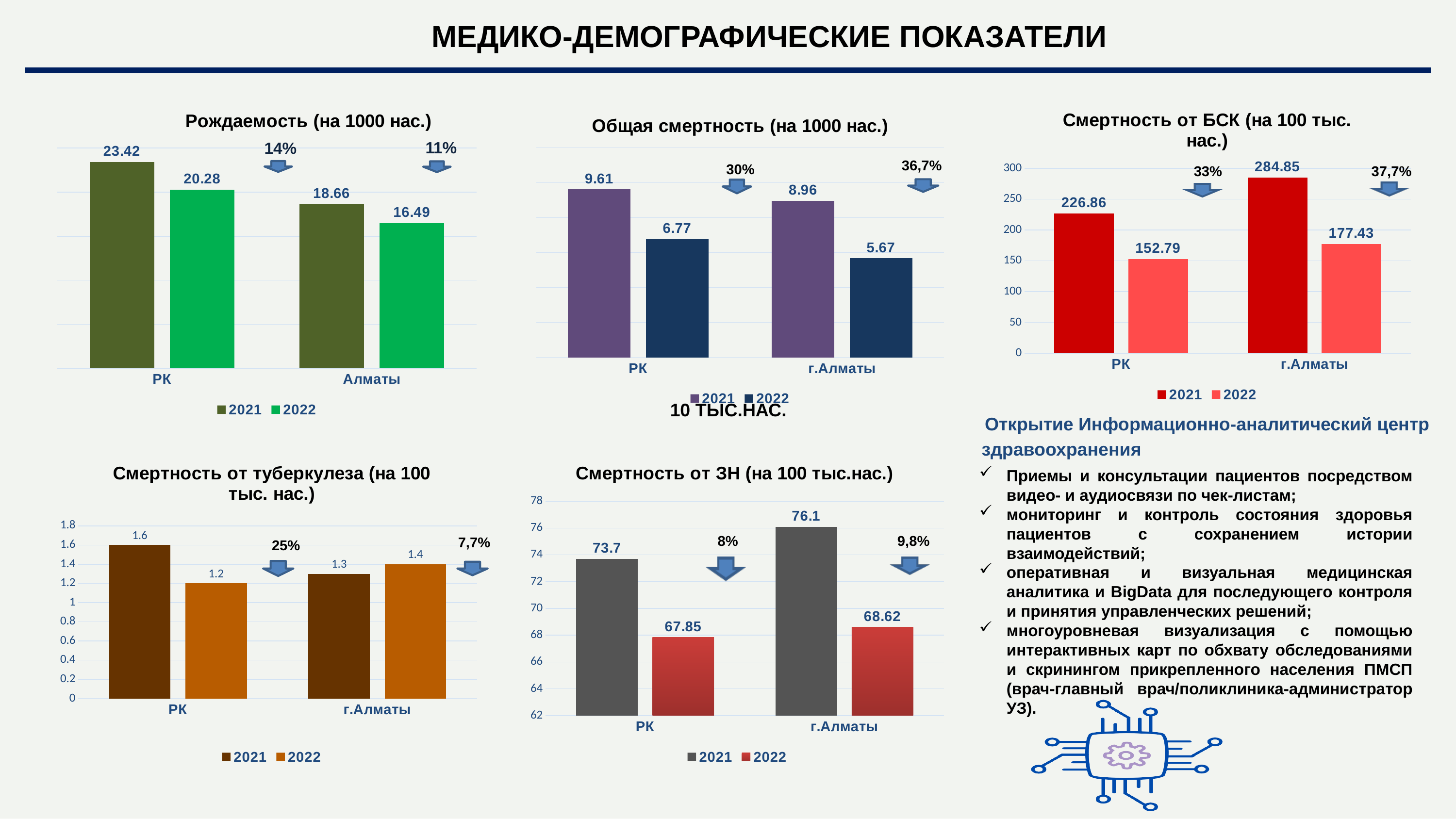
In the chart titled 'Смертность от туберкулеза (на 100 тыс. нас.)', what is the value for РК in 2022? 1.2 In the chart titled 'Общая смертность (на 1000 нас.)', what is the value for г.Алматы in 2022? 5.67 In the chart titled 'Смертность от БСК (на 100 тыс. нас.)', which bar is the highest? г.Алматы 2021 What type of chart is the chart titled 'Смертность от БСК (на 100 тыс. нас.)'? Bar chart In the chart titled 'Смертность от ЗН (на 100 тыс.нас.)', which bar is the lowest? РК 2022 In the chart titled 'Смертность от туберкулеза (на 100 тыс. нас.)', which is larger: г.Алматы in 2021 or г.Алматы in 2022? г.Алматы in 2022 How many series does the legend list in the chart titled 'Смертность от ЗН (на 100 тыс.нас.)'? 2 In the chart titled 'Рождаемость (на 1000 нас.)', what is the value for РК in 2021? 23.42 In the chart titled 'Общая смертность (на 1000 нас.)', what is the difference between the РК values for 2021 and 2022? 2.84 In the chart titled 'Смертность от ЗН (на 100 тыс.нас.)', what is the value for г.Алматы in 2021? 76.1 In the chart titled 'Смертность от БСК (на 100 тыс. нас.)', what is the value for РК in 2022? 152.79 In the chart titled 'Рождаемость (на 1000 нас.)', what is the value for Алматы in 2022? 16.49